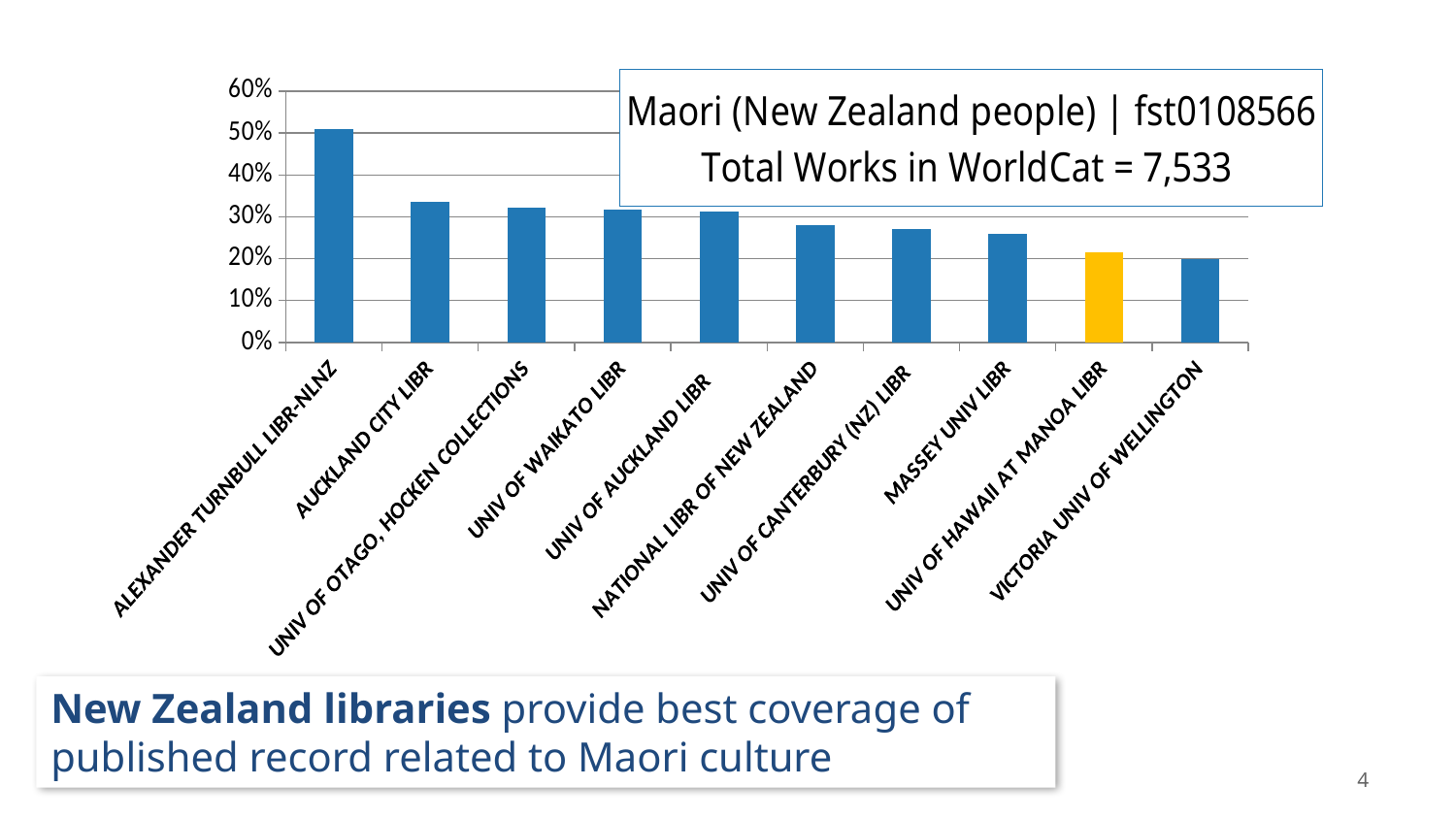
Is the value for MASSEY UNIV LIBR greater or less than 30%? less What kind of chart is shown on the slide? Bar chart Is the value for UNIV OF HAWAII AT MANOA LIBR greater or less than 30%? less Do the bar values generally rise or fall from left to right along the x axis? Fall How many libraries are shown on the x axis of the chart? 10 Which has a larger value, UNIV OF AUCKLAND LIBR or VICTORIA UNIV OF WELLINGTON? UNIV OF AUCKLAND LIBR Is the value for AUCKLAND CITY LIBR greater or less than 30%? greater Which has a larger value, ALEXANDER TURNBULL LIBR-NLNZ or AUCKLAND CITY LIBR? ALEXANDER TURNBULL LIBR-NLNZ Which library has the lowest value in the chart? VICTORIA UNIV OF WELLINGTON Which library has the highest value in the chart? ALEXANDER TURNBULL LIBR-NLNZ Which library's bar is highlighted in a different colour (yellow) from the others? UNIV OF HAWAII AT MANOA LIBR